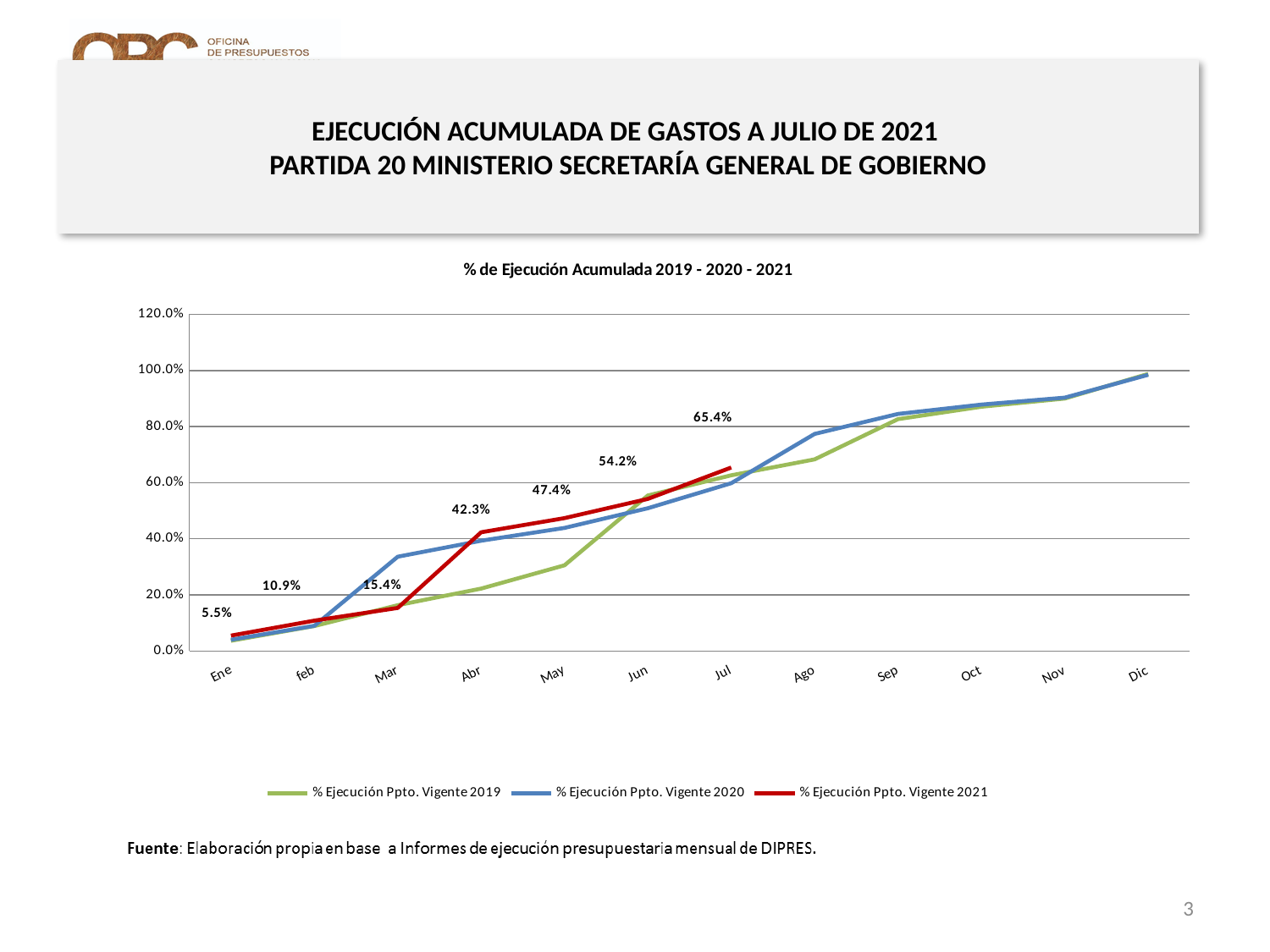
Does the % Ejecución Ppto. Vigente 2021 line rise or fall from Ene to Jul? rise What is the value for % Ejecución Ppto. Vigente 2021 in Jul? 65.4% How many series does the legend list? 3 What type of chart is shown on the slide? line chart Is the value for % Ejecución Ppto. Vigente 2020 in Dic greater or less than 80.0%? greater What is the difference between the 2021 values for Abr and Mar? 26.9% What is the difference between the 2021 values for Jul and Jun? 11.2% What is the title of the chart? % de Ejecución Acumulada 2019 - 2020 - 2021 Is the value for % Ejecución Ppto. Vigente 2019 in May greater or less than 40.0%? less What is the value for % Ejecución Ppto. Vigente 2021 in Ene? 5.5% How many months are shown on the x axis? 12 What is the value for % Ejecución Ppto. Vigente 2021 in Abr? 42.3%